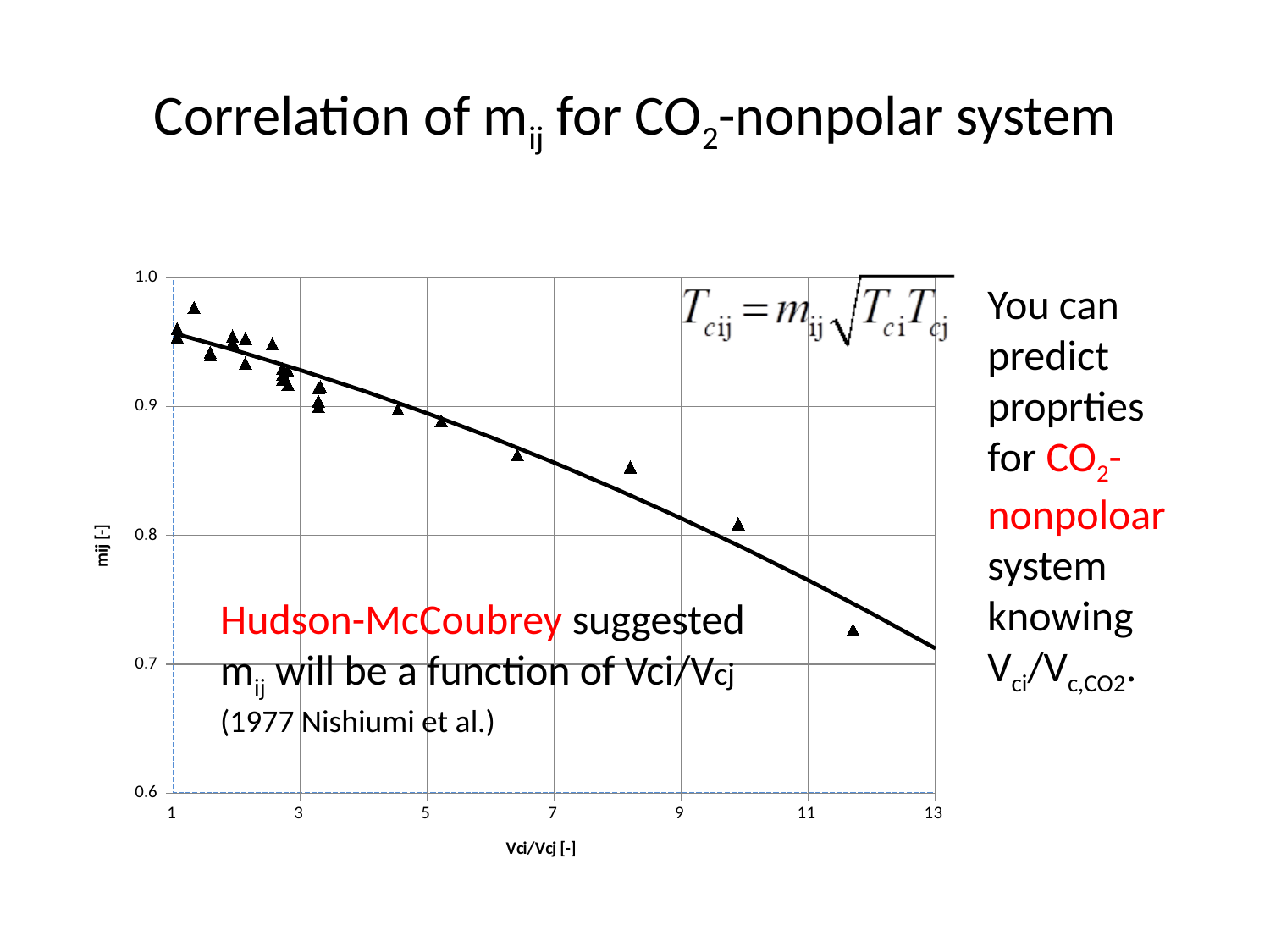
What is the label on the y axis of the chart? mij [-] Do the plotted mij values rise or fall as Vci/Vcj increases along the x axis? fall Which has the larger mij value: the data point near Vci/Vcj of 4.6 or the data point near Vci/Vcj of 10? the point near Vci/Vcj of 4.6 Is the value of mij for the data point near Vci/Vcj of 8.2 greater or less than 0.9? less Is the value of mij for the highest data point (near Vci/Vcj of 1.3) greater or less than 0.9? greater Is the value of mij for the data point near Vci/Vcj of 8.2 greater or less than 0.8? greater What kind of chart is shown on the slide? scatter chart What is the label on the x axis of the chart? Vci/Vcj [-]